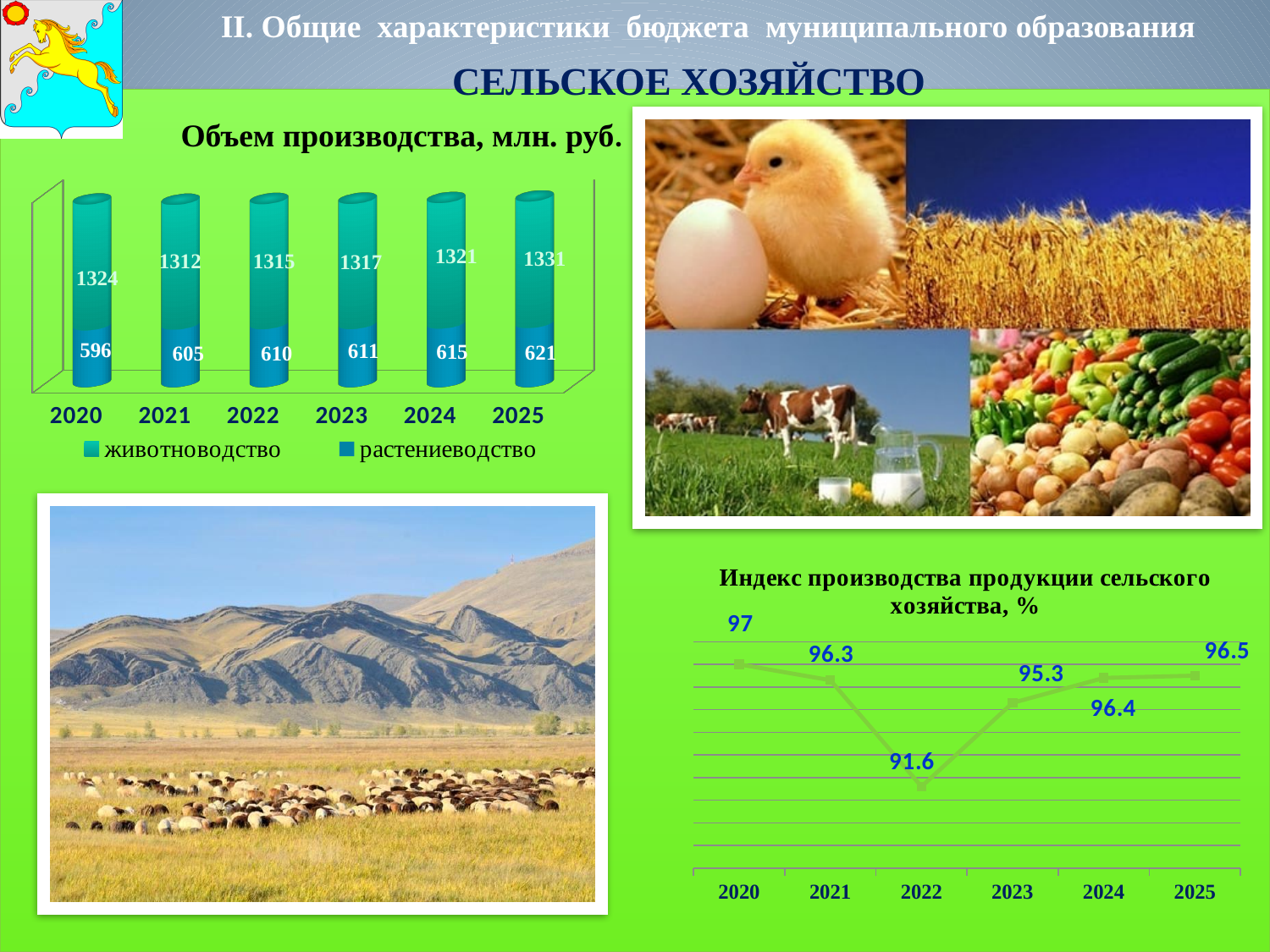
In the chart 'Объем производства, млн. руб.', what is the difference between животноводство in 2025 and in 2020? 7 In the chart 'Объем производства, млн. руб.', how many series does the legend list? 2 In the chart 'Объем производства, млн. руб.', what is the total of the stacked bar for 2020? 1920 In the chart 'Объем производства, млн. руб.', which year has the highest value for растениеводство? 2025 In the chart 'Индекс производства продукции сельского хозяйства, %', is the value for 2023 larger or smaller than the value for 2024? smaller In the chart 'Объем производства, млн. руб.', what is the value for животноводство in 2020? 1324 In the chart 'Индекс производства продукции сельского хозяйства, %', how many years are plotted? 6 In the chart 'Индекс производства продукции сельского хозяйства, %', which year has the lowest value? 2022 In the chart 'Индекс производства продукции сельского хозяйства, %', which year has the highest value? 2020 In the chart 'Объем производства, млн. руб.', what is the value for растениеводство in 2025? 621 In the chart 'Индекс производства продукции сельского хозяйства, %', what is the value for 2022? 91.6 What kind of chart is 'Объем производства, млн. руб.'? stacked bar chart